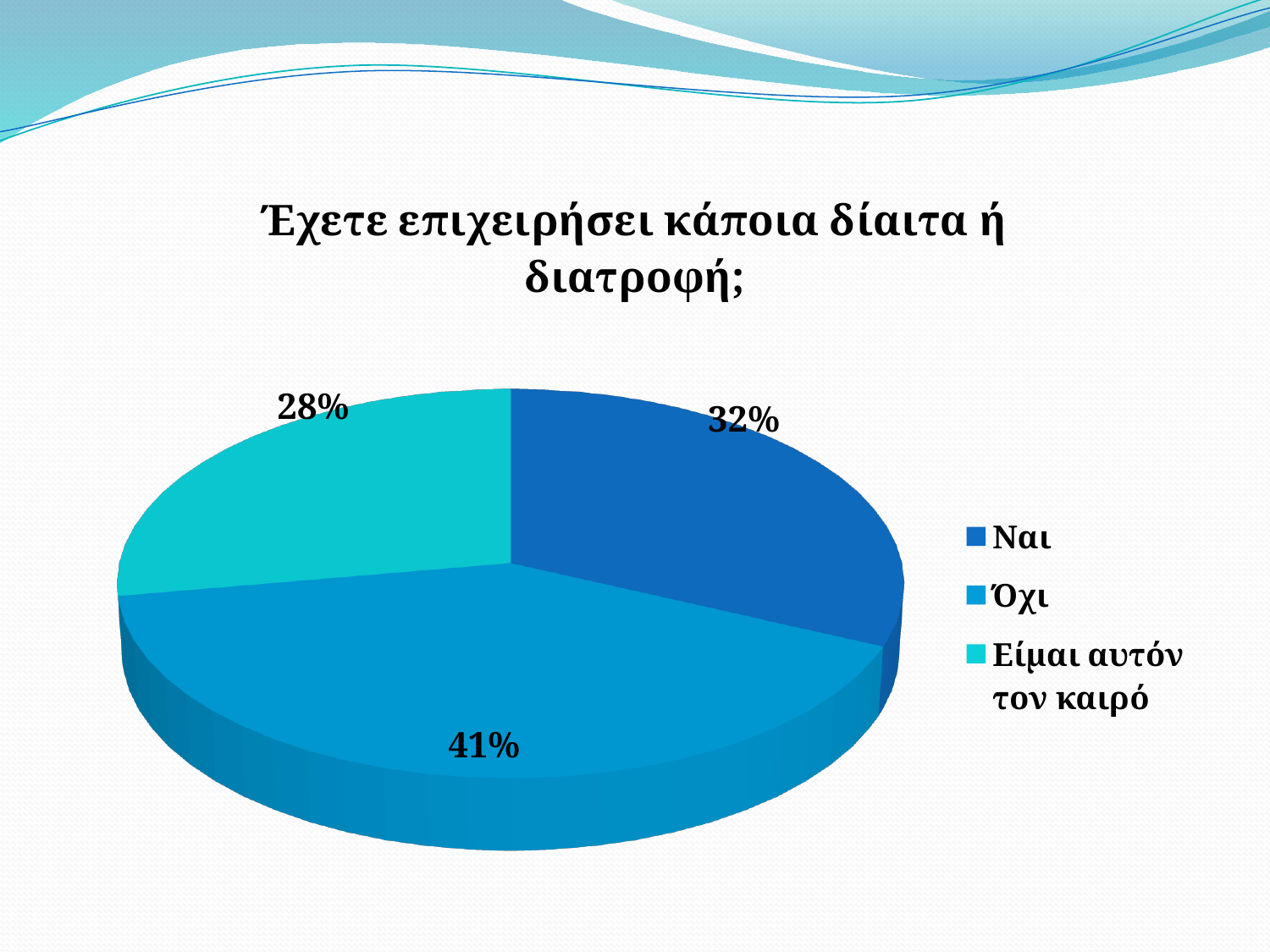
What percentage of the pie is labelled Ναι? 32% What kind of chart is shown on the slide? Pie chart Which category has the largest share of the pie? Όχι Which is larger, the share for Ναι or the share for Όχι? Όχι Which category has the smallest share of the pie? Είμαι αυτόν τον καιρό What percentage of the pie is labelled Είμαι αυτόν τον καιρό? 28% What is the difference in percentage points between Όχι and Ναι? 9 How many categories does the pie chart show? 3 Which legend entry is shown in the lightest (turquoise) colour? Είμαι αυτόν τον καιρό What percentage of the pie is labelled Όχι? 41% What is the title of the chart? Έχετε επιχειρήσει κάποια δίαιτα ή διατροφή; What is the difference in percentage points between Ναι and Είμαι αυτόν τον καιρό? 4